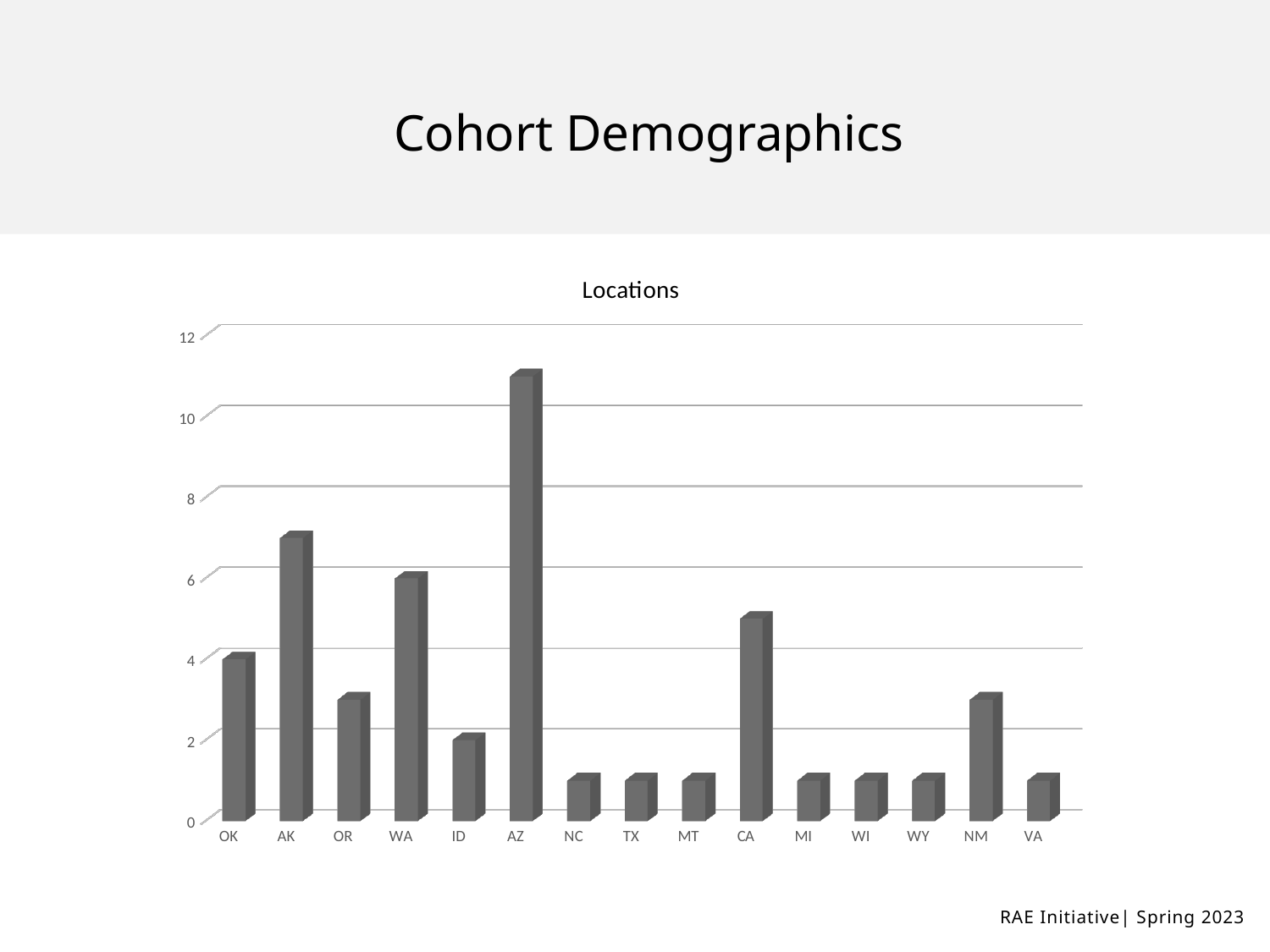
How many categories (states) are shown on the x axis of the chart? 15 Which has the larger value, CA or OR? CA Which state has the highest bar in the chart? AZ What is the title of the chart? Locations Which has the larger value, AK or WA? AK What is the value for OK? 4 Is the value for NM greater or less than 4? less Is the value for NC greater or less than 2? less Is the value for AK greater or less than 6? greater What kind of chart is shown on the slide? bar chart